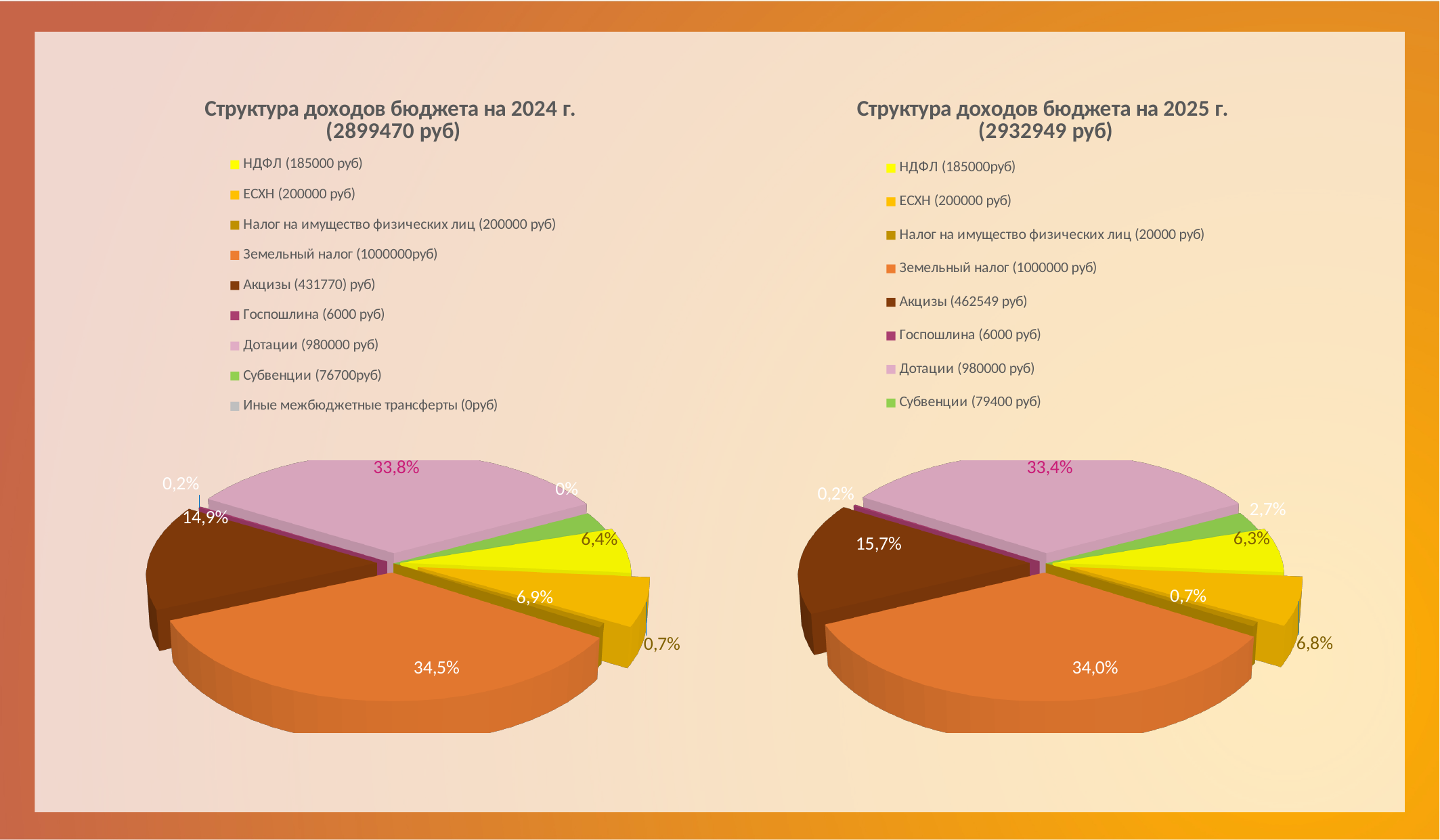
In the 2024 chart, what share does Акцизы have? 14,9% In the 2024 chart, what share does Земельный налог have? 34,5% What total budget amount is shown in the title of the 2025 chart? 2932949 руб In the 2025 chart, which is larger: the share of НДФЛ or the share of Акцизы? Акцизы In the 2024 chart, what share does Дотации have? 33,8% How many categories does the legend of the 2024 chart list? 9 How many categories does the legend of the 2025 chart list? 8 In the 2025 chart, what share does Акцизы have? 15,7% What kind of chart is used for 'Структура доходов бюджета на 2024 г.'? pie chart In the 2025 chart, what share does Земельный налог have? 34,0% In the 2025 chart, what share does Субвенции have? 2,7% In the 2024 chart, which category has the largest slice? Земельный налог